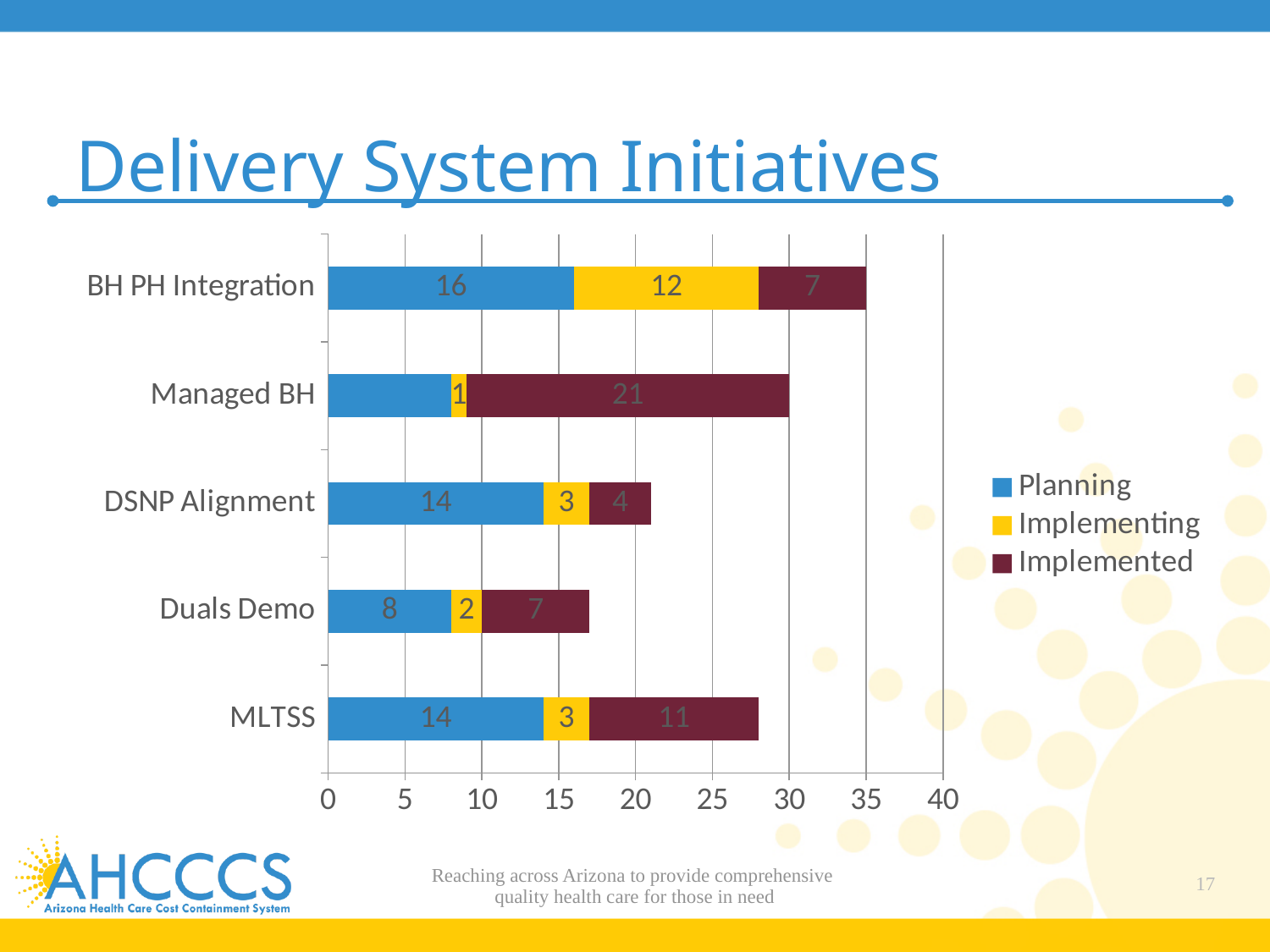
What is the Planning value for BH PH Integration? 16 Is the Planning value for Managed BH greater or less than 10? less Which initiative has the lowest Implementing value? Managed BH How many initiatives are shown on the chart? 5 What is the total of the stacked bar for Duals Demo? 17 What is the total of the stacked bar for BH PH Integration? 35 What is the difference between the Implemented values for MLTSS and DSNP Alignment? 7 Which has a larger Planning value, BH PH Integration or Duals Demo? BH PH Integration How many series does the legend list? 3 What is the Implementing value for DSNP Alignment? 3 What is the Implemented value for Managed BH? 21 Which initiative has the highest Implemented value? Managed BH